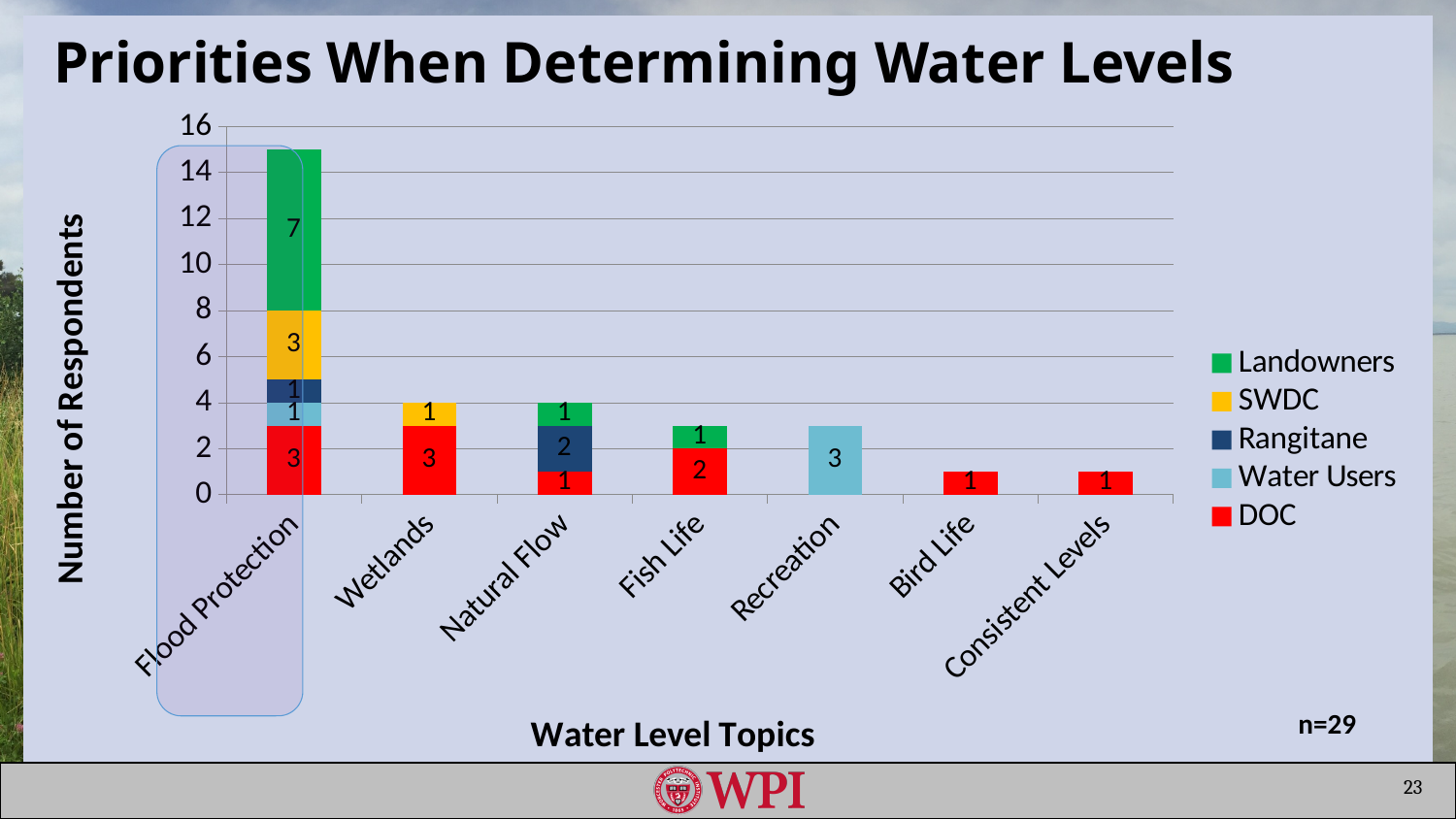
How many DOC respondents chose Wetlands? 3 What is the total number of respondents for Natural Flow? 4 How many Landowners respondents chose Flood Protection? 7 Which is larger: the DOC value for Fish Life or the DOC value for Bird Life? Fish Life How many Rangitane respondents chose Natural Flow? 2 What kind of chart is shown on the slide? stacked bar chart What is the difference between the Landowners value for Flood Protection and the SWDC value for Flood Protection? 4 Which water level topic has the highest total number of respondents? Flood Protection How many series does the legend list? 5 What is the total number of respondents for Flood Protection? 15 How many Water Users respondents chose Recreation? 3 How many water level topics are shown on the x axis? 7